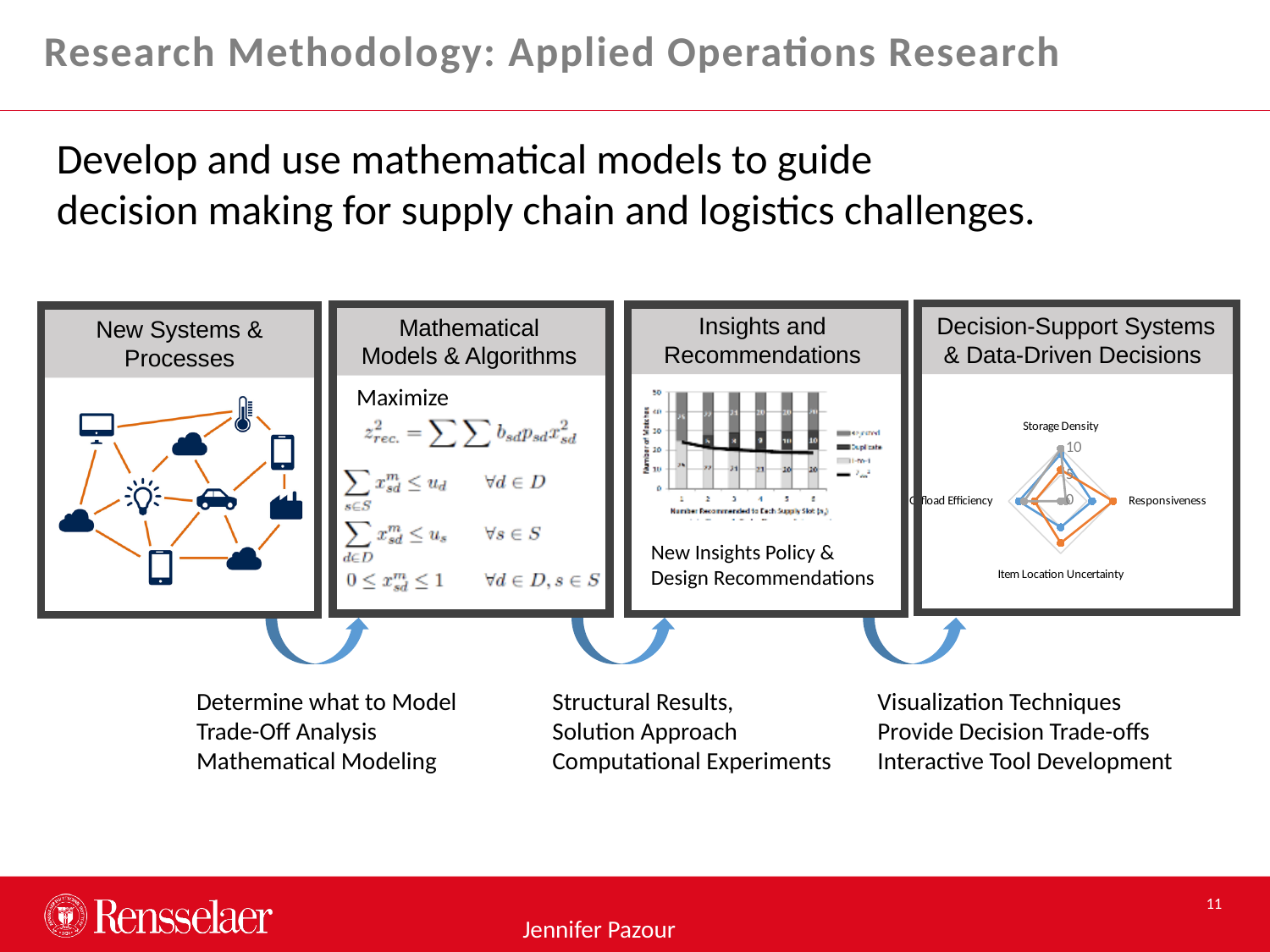
What kind of chart is shown in the 'Insights and Recommendations' box? Bar chart How many bars are shown in the bar chart in the 'Insights and Recommendations' box? 6 In the radar chart in the 'Decision-Support Systems & Data-Driven Decisions' box, is the orange series' value for Responsiveness greater or less than 5? greater In the radar chart in the 'Decision-Support Systems & Data-Driven Decisions' box, which category is at the top of the chart? Storage Density In the radar chart in the 'Decision-Support Systems & Data-Driven Decisions' box, is the gray series' value for Responsiveness greater or less than 5? less In the radar chart in the 'Decision-Support Systems & Data-Driven Decisions' box, is the blue series' value for Storage Density greater or less than 5? greater How many axes (categories) does the radar chart in the 'Decision-Support Systems & Data-Driven Decisions' box have? 4 In the radar chart in the 'Decision-Support Systems & Data-Driven Decisions' box, which category is at the bottom of the chart? Item Location Uncertainty In the radar chart in the 'Decision-Support Systems & Data-Driven Decisions' box, which series has the larger value for Responsiveness, the orange series or the blue series? Orange series What kind of chart is shown in the 'Decision-Support Systems & Data-Driven Decisions' box? Radar chart What is the highest tick value shown on the radar chart in the 'Decision-Support Systems & Data-Driven Decisions' box? 10